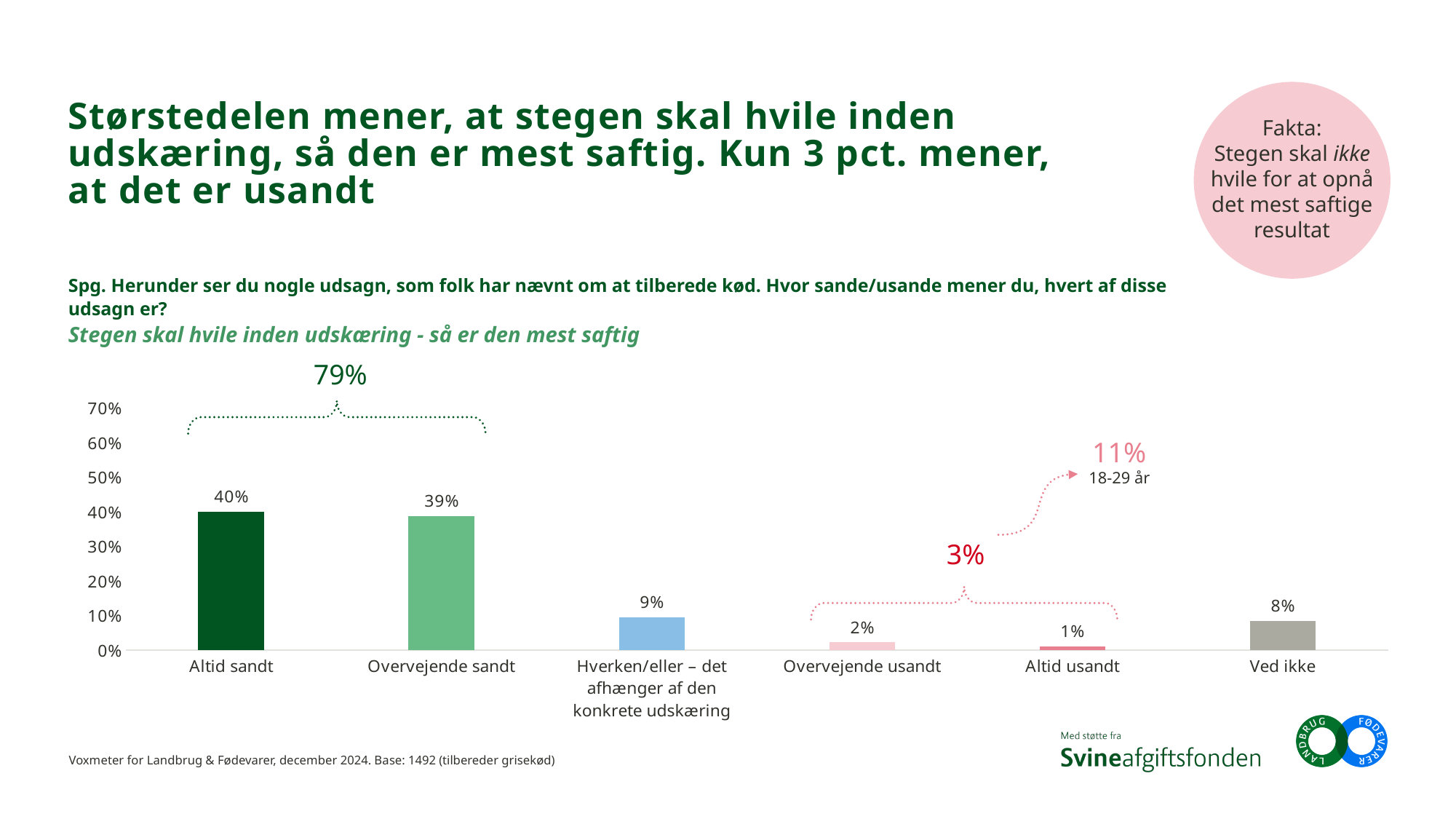
What kind of chart is shown on the slide? Bar chart What is the value for "Altid sandt"? 40% Which category has the lowest value? Altid usandt What is the value for "Hverken/eller – det afhænger af den konkrete udskæring"? 9% How many categories are shown on the x axis? 6 What is the difference between the values for "Altid sandt" and "Overvejende sandt"? 1% Which category has the highest value? Altid sandt What is the value for "Overvejende sandt"? 39% What is the difference between the values for "Hverken/eller – det afhænger af den konkrete udskæring" and "Ved ikke"? 1% Which is larger, the value for "Overvejende usandt" or the value for "Altid usandt"? Overvejende usandt What is the value for "Ved ikke"? 8% What combined percentage is shown above the bracket spanning "Overvejende usandt" and "Altid usandt"? 3%